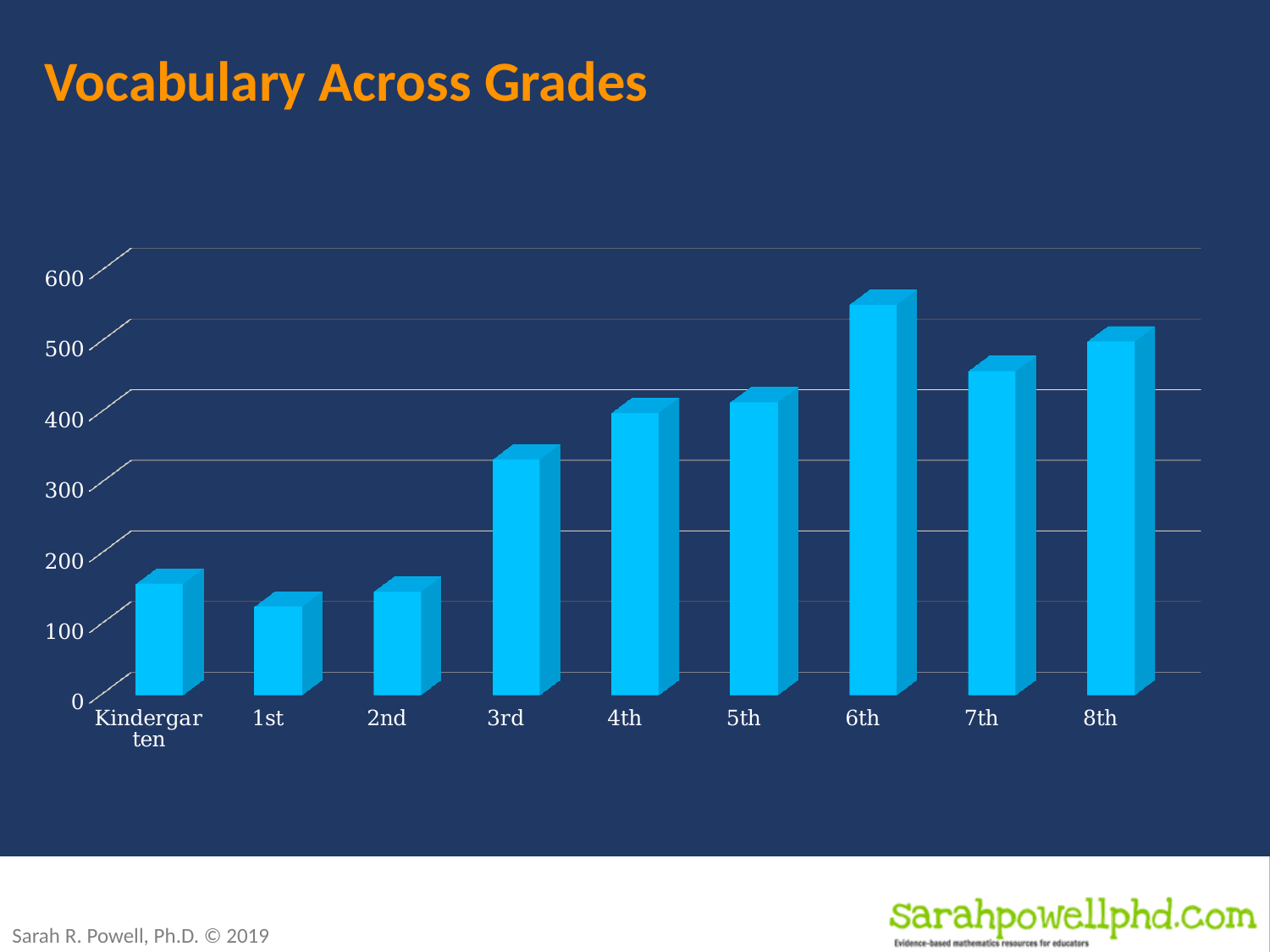
What kind of chart is shown on the slide? bar chart Which grade has the highest bar? 6th How many grade categories are shown on the x axis? 9 Which is larger, the value for 6th grade or the value for 8th grade? 6th Is the value for Kindergarten greater or less than 300? less What is the title of the chart? Vocabulary Across Grades Which is larger, the value for 2nd grade or the value for 3rd grade? 3rd Is the value for 6th grade greater or less than 400? greater Do the values generally rise or fall from Kindergarten to 8th grade? rise Which grade has the lowest bar? 1st Is the value for 3rd grade greater or less than 200? greater